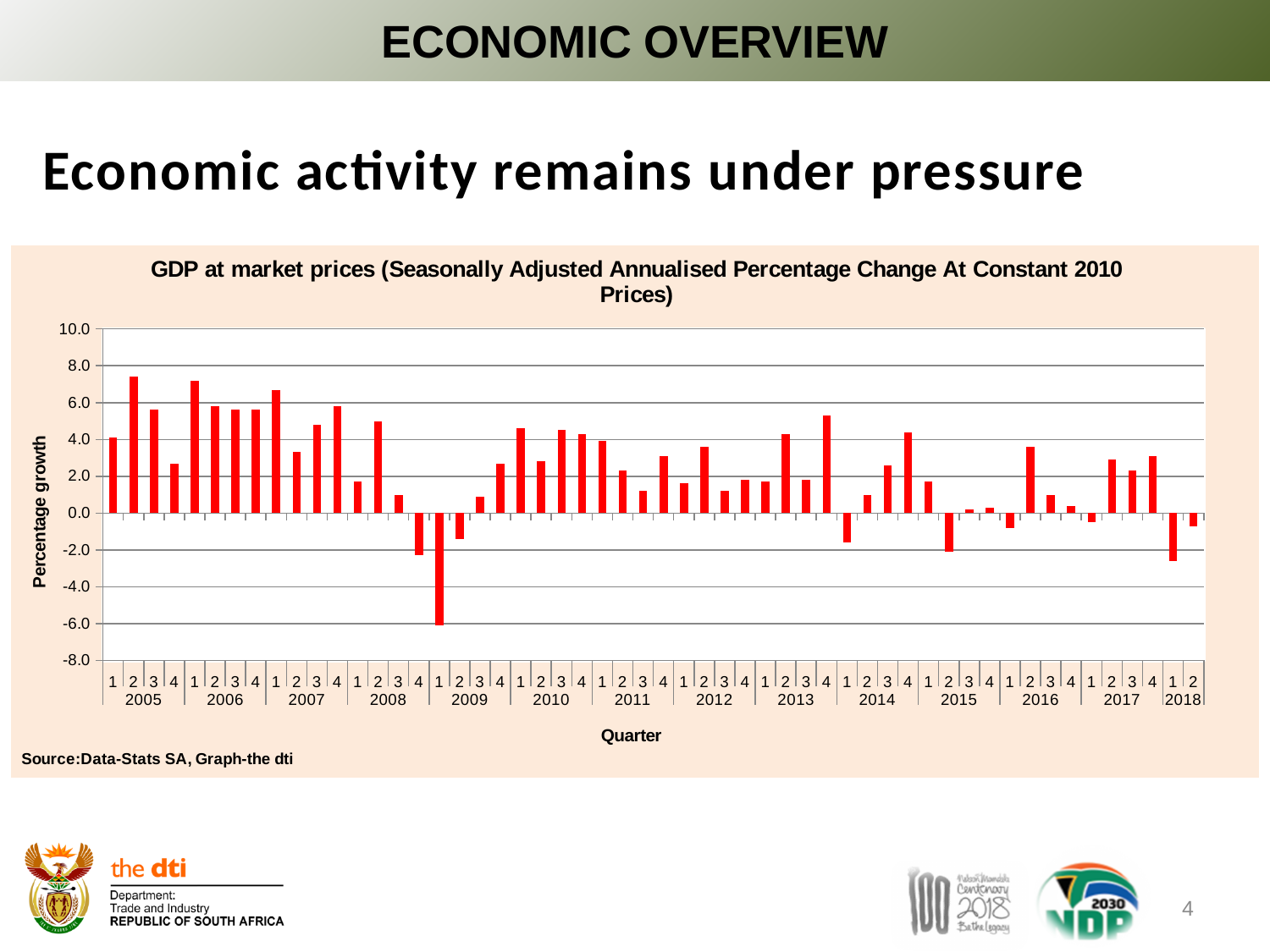
Which quarter has the lowest GDP growth value in the chart? Quarter 1 of 2009 Which is larger, the value for quarter 4 of 2013 or the value for quarter 1 of 2014? Quarter 4 of 2013 Is the value for quarter 2 of 2005 greater or less than 6.0? greater Which is larger, the value for quarter 2 of 2005 or the value for quarter 1 of 2018? Quarter 2 of 2005 How many quarterly bars are plotted in the chart? 54 What is the label on the vertical axis of the chart? Percentage growth Is the value for quarter 1 of 2018 greater or less than -2.0? less Is the value for quarter 2 of 2016 greater or less than 2.0? greater Do the GDP growth values generally rise or fall from 2005 to 2018? fall What kind of chart is shown on the slide? Bar chart